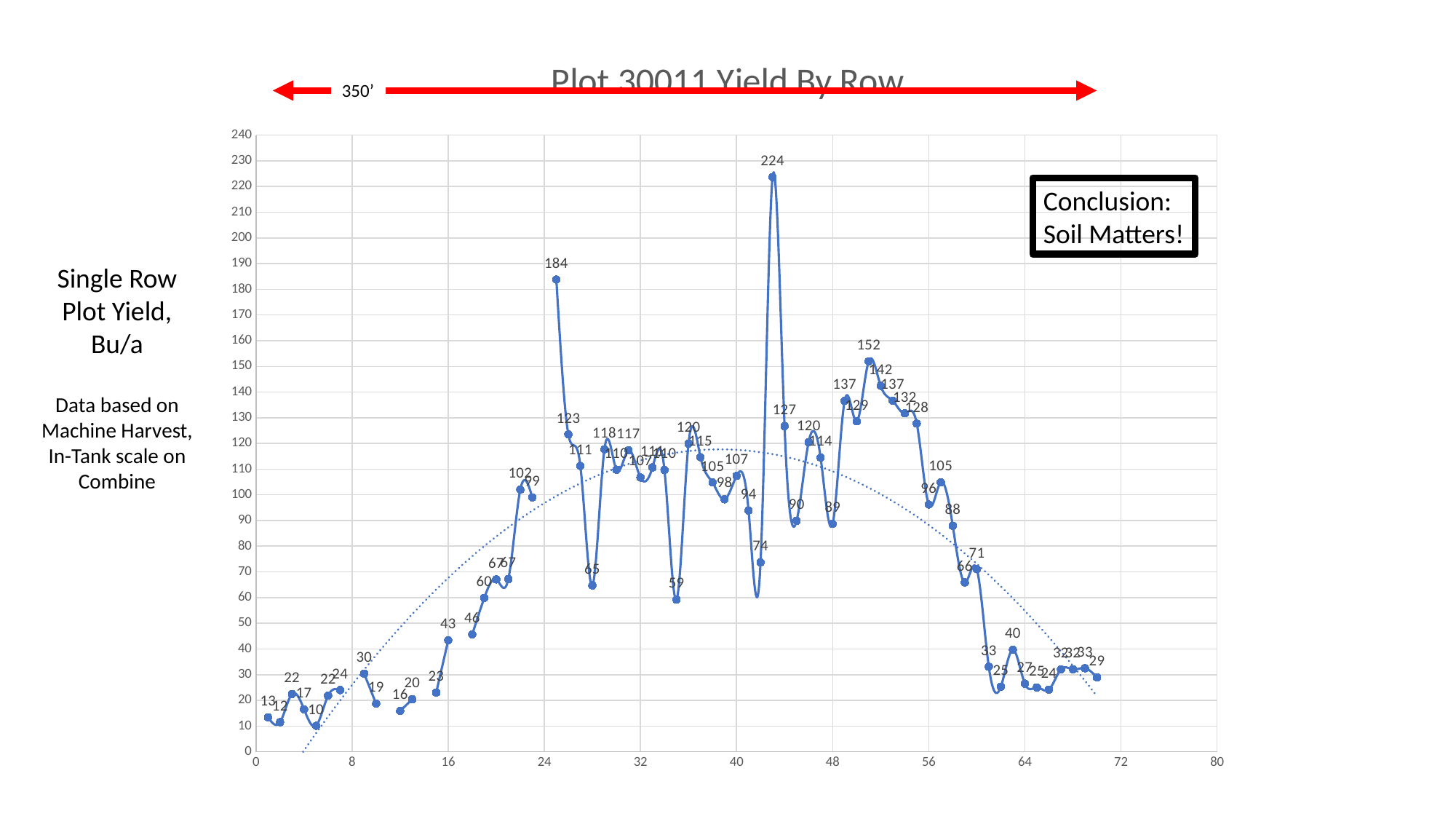
Which is larger, the first labelled value on the left (13) or the last labelled value on the right (29)? 29 Is the value of the tallest spike near x = 44 greater or less than 200? greater What is the highest data-labelled value on the Plot 30011 Yield By Row chart? 224 What is the title of the chart? Plot 30011 Yield By Row What is the difference between the labelled values 152 and 137 on the chart? 15 What kind of chart is shown on the slide? line chart Is the value of the tallest spike near x = 24 greater or less than 150? greater What is the difference between the two highest labelled values (224 and 184) on the chart? 40 What is the lowest data-labelled value on the Plot 30011 Yield By Row chart? 10 Do the values generally rise or fall along the x axis between 0 and 24? rise What is the highest tick value shown on the vertical axis of the chart? 240 Do the values generally rise or fall along the x axis between 56 and 72? fall